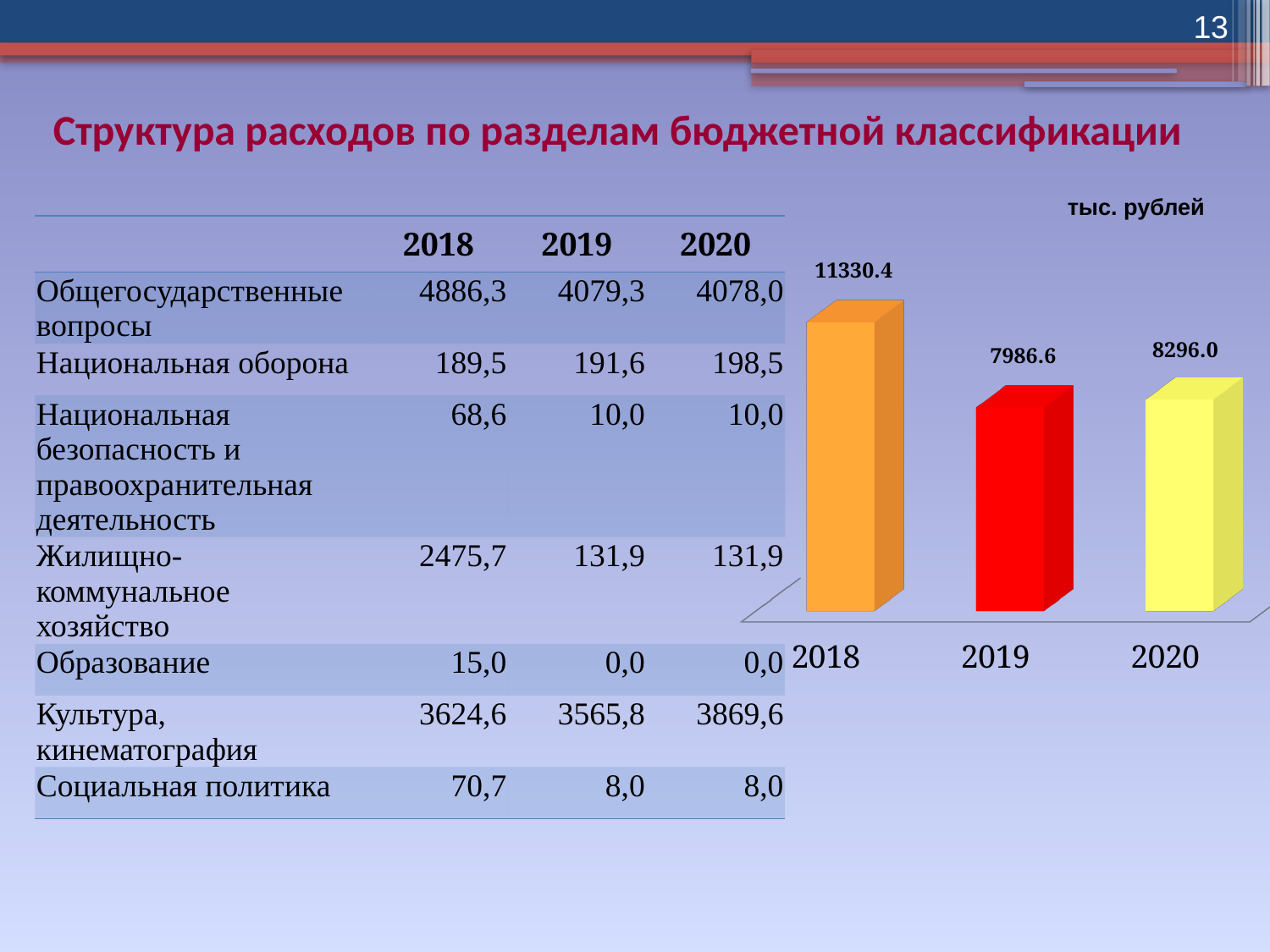
Does the value fall or rise from 2018 to 2019 in the chart? fall What is the difference between the 2020 and 2019 values in the chart? 309.4 Which year has the highest bar in the chart? 2018 What is the value of the bar for 2018 in the chart? 11330.4 What is the value of the bar for 2019 in the chart? 7986.6 What kind of chart is shown on the slide? bar chart What is the difference between the 2018 and 2019 values in the chart? 3343.8 How many bars are shown in the chart? 3 Which is larger in the chart, the value for 2019 or the value for 2020? 2020 What unit is indicated above the chart? тыс. рублей Which year has the lowest bar in the chart? 2019 What is the value of the bar for 2020 in the chart? 8296.0